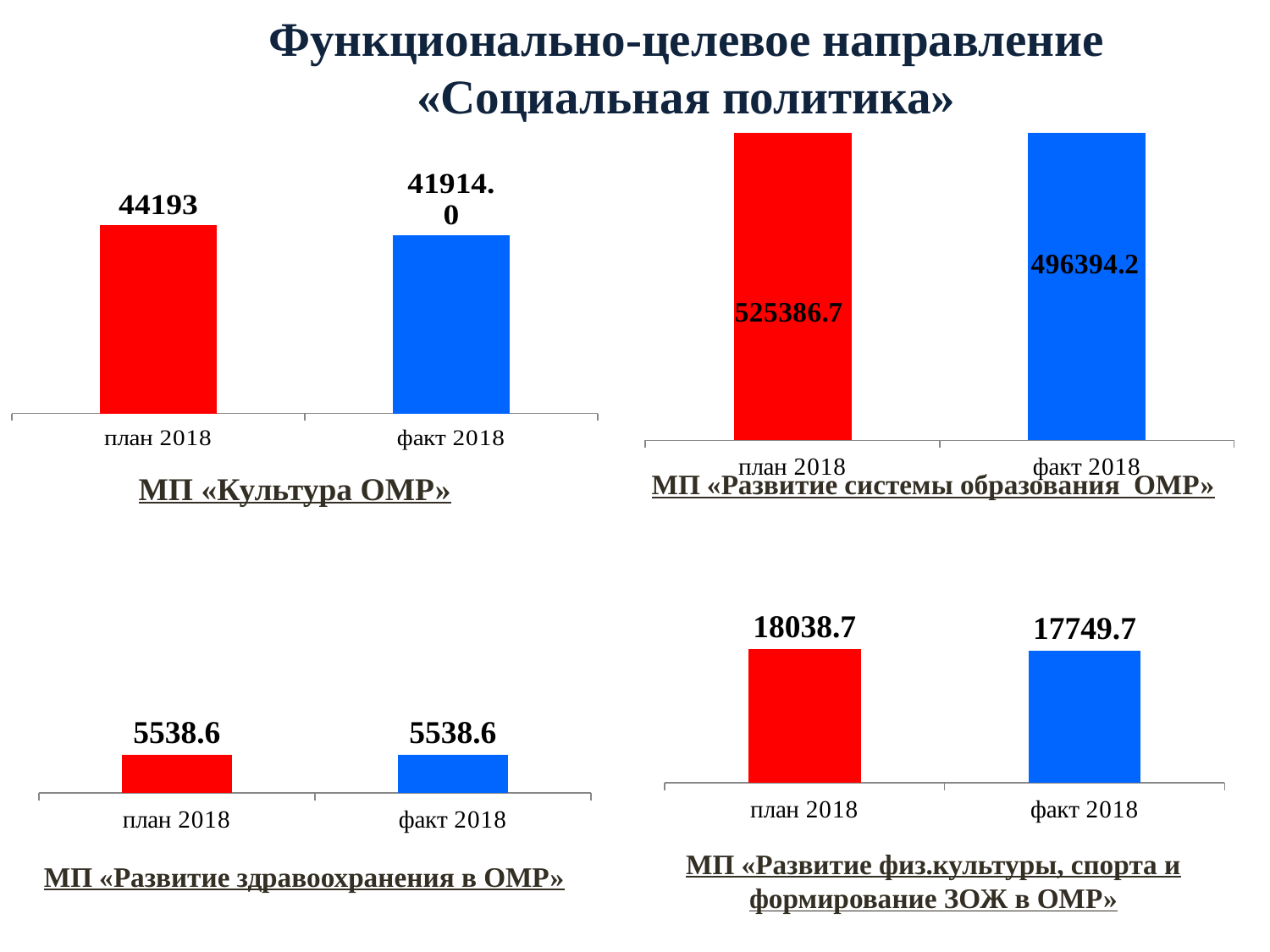
How many categories are shown in the chart titled МП «Развитие здравоохранения в ОМР»? 2 In the chart titled МП «Культура ОМР», what is the value for план 2018? 44193 In the chart titled МП «Культура ОМР», which is larger, план 2018 or факт 2018? план 2018 In the chart titled МП «Развитие системы образования ОМР», what is the difference between план 2018 and факт 2018? 28992.5 In the chart titled МП «Развитие системы образования ОМР», what is the value for план 2018? 525386.7 In the chart titled МП «Культура ОМР», what is the value for факт 2018? 41914.0 In the chart titled МП «Развитие системы образования ОМР», what is the value for факт 2018? 496394.2 In the chart titled МП «Развитие здравоохранения в ОМР», what is the value for факт 2018? 5538.6 In the chart titled МП «Развитие физ.культуры, спорта и формирование ЗОЖ в ОМР», what is the difference between план 2018 and факт 2018? 289.0 In the chart titled МП «Развитие физ.культуры, спорта и формирование ЗОЖ в ОМР», what is the value for план 2018? 18038.7 What kind of chart is the one titled МП «Культура ОМР»? bar chart In the chart titled МП «Развитие физ.культуры, спорта и формирование ЗОЖ в ОМР», what is the value for факт 2018? 17749.7